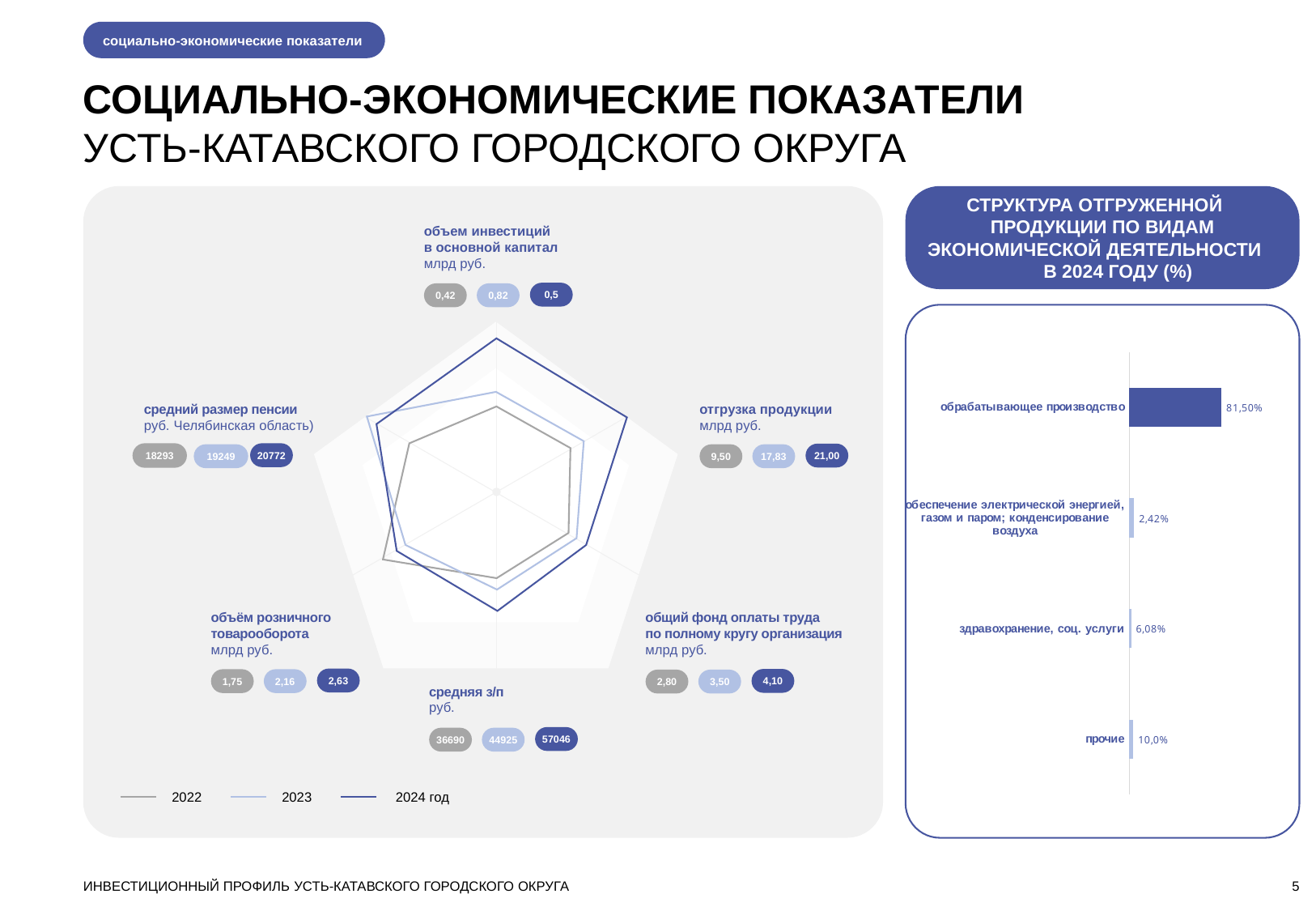
On the left radar chart, how many series does the legend list? 3 On the left radar chart, what is the value of средняя з/п for 2024? 57046 On the left radar chart, which year has the larger value for объем инвестиций в основной капитал: 2023 or 2024? 2023 On the right chart (Структура отгруженной продукции в 2024 году), how many categories are shown? 4 On the right chart (Структура отгруженной продукции в 2024 году), which category has the highest value? обрабатывающее производство On the right chart (Структура отгруженной продукции в 2024 году), what is the value for обрабатывающее производство? 81,50% On the right chart (Структура отгруженной продукции в 2024 году), what is the difference between здравоохранение, соц. услуги and обеспечение электрической энергией, газом и паром; конденсирование воздуха? 3,66% What kind of chart is the right chart (Структура отгруженной продукции в 2024 году)? bar chart On the left radar chart, what is the value of отгрузка продукции for 2023? 17,83 What kind of chart is the left chart with the 2022, 2023 and 2024 series? radar chart On the right chart (Структура отгруженной продукции в 2024 году), what is the value for прочие? 10,0% On the right chart (Структура отгруженной продукции в 2024 году), which category has the lowest value? обеспечение электрической энергией, газом и паром; конденсирование воздуха